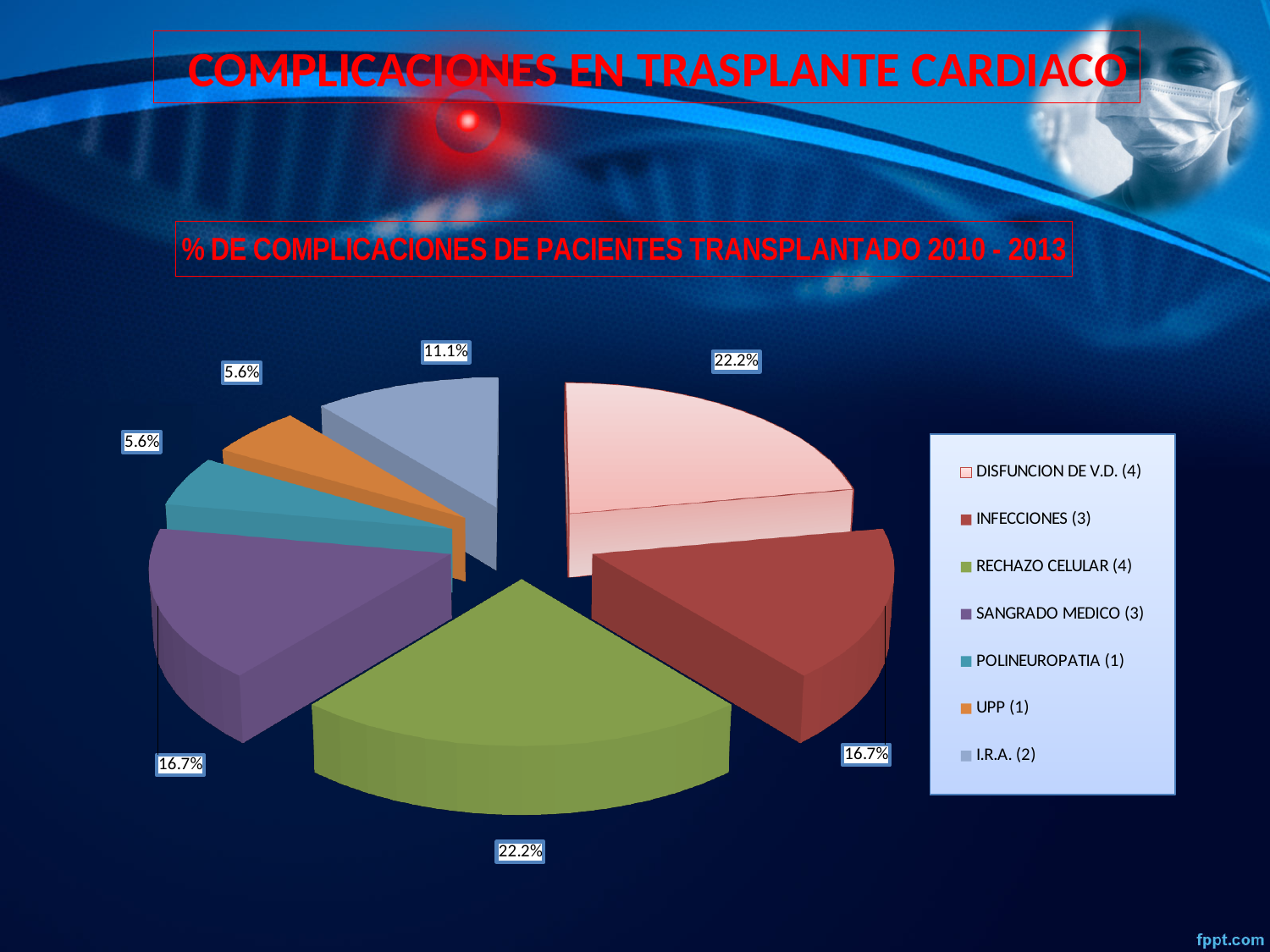
What type of chart is shown on the slide? Pie chart What is the title of the chart? % DE COMPLICACIONES DE PACIENTES TRANSPLANTADO 2010 - 2013 What is the difference in percentage points between DISFUNCION DE V.D. (4) and SANGRADO MEDICO (3)? 5.5 What is the difference in percentage points between RECHAZO CELULAR (4) and UPP (1)? 16.6 What percentage of the pie does DISFUNCION DE V.D. (4) represent? 22.2% What percentage is shown for RECHAZO CELULAR (4)? 22.2% What percentage is shown for I.R.A. (2)? 11.1% Which is larger, the share for INFECCIONES (3) or the share for I.R.A. (2)? INFECCIONES (3) How many categories does the pie chart have? 7 What percentage is shown for POLINEUROPATIA (1)? 5.6% What percentage is shown for SANGRADO MEDICO (3)? 16.7% What percentage is shown for INFECCIONES (3)? 16.7%